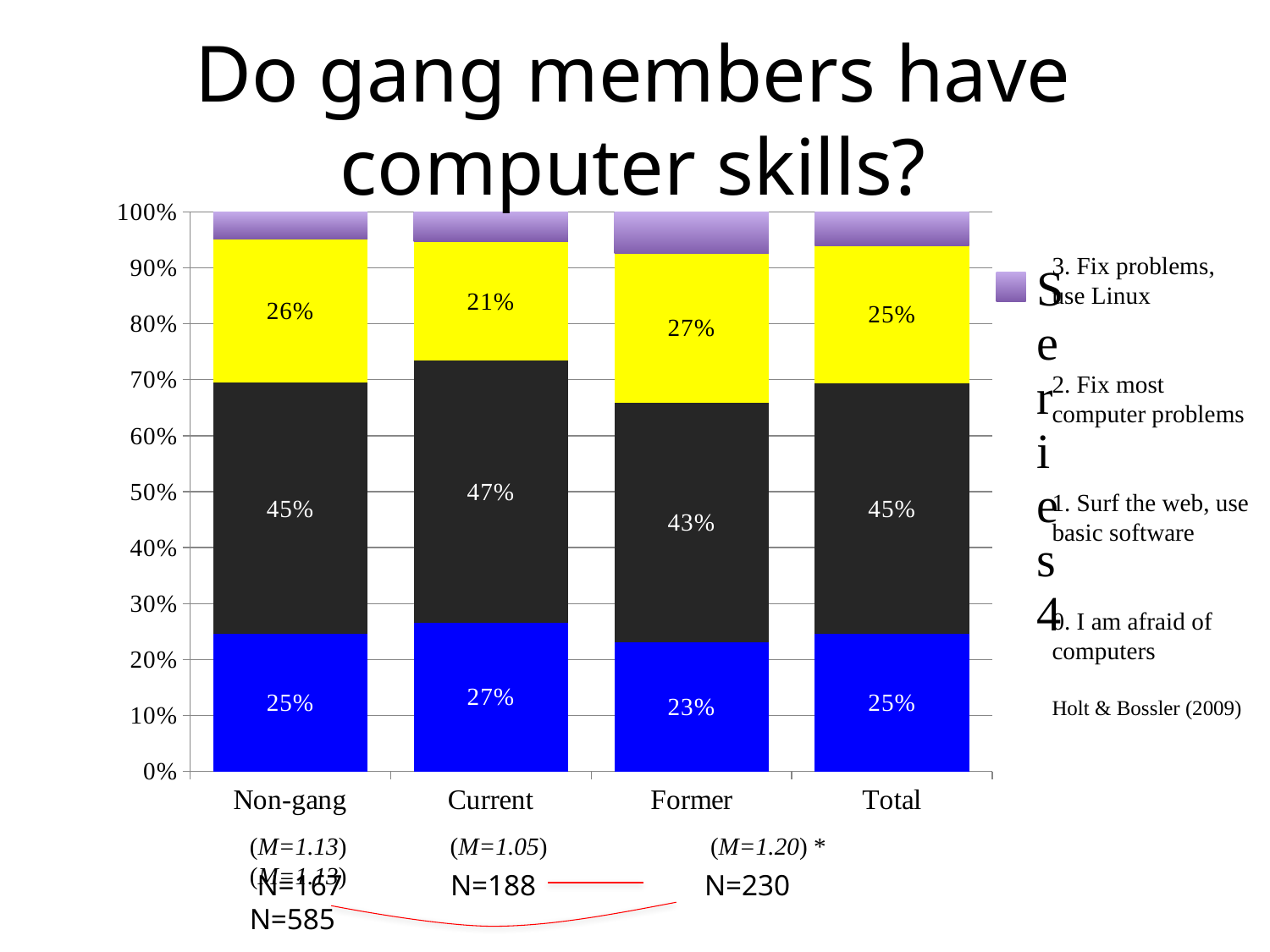
What is the title of the chart on the slide? Do gang members have computer skills? Is the '1. Surf the web, use basic software' value for Total greater or less than 40%? greater Which is larger: the '2. Fix most computer problems' value for Non-gang or for Current? Non-gang Which category has the highest value for '1. Surf the web, use basic software'? Current What is the difference between the '0. I am afraid of computers' values for Current and Former? 4% What is the value of the '1. Surf the web, use basic software' segment for Current? 47% How many series does the legend list? 4 How many categories are shown on the x axis? 4 Which category has the lowest value for '2. Fix most computer problems'? Current What type of chart is shown on the slide? stacked bar chart What is the value of the '0. I am afraid of computers' segment for Non-gang? 25% What is the value of the '2. Fix most computer problems' segment for Former? 27%